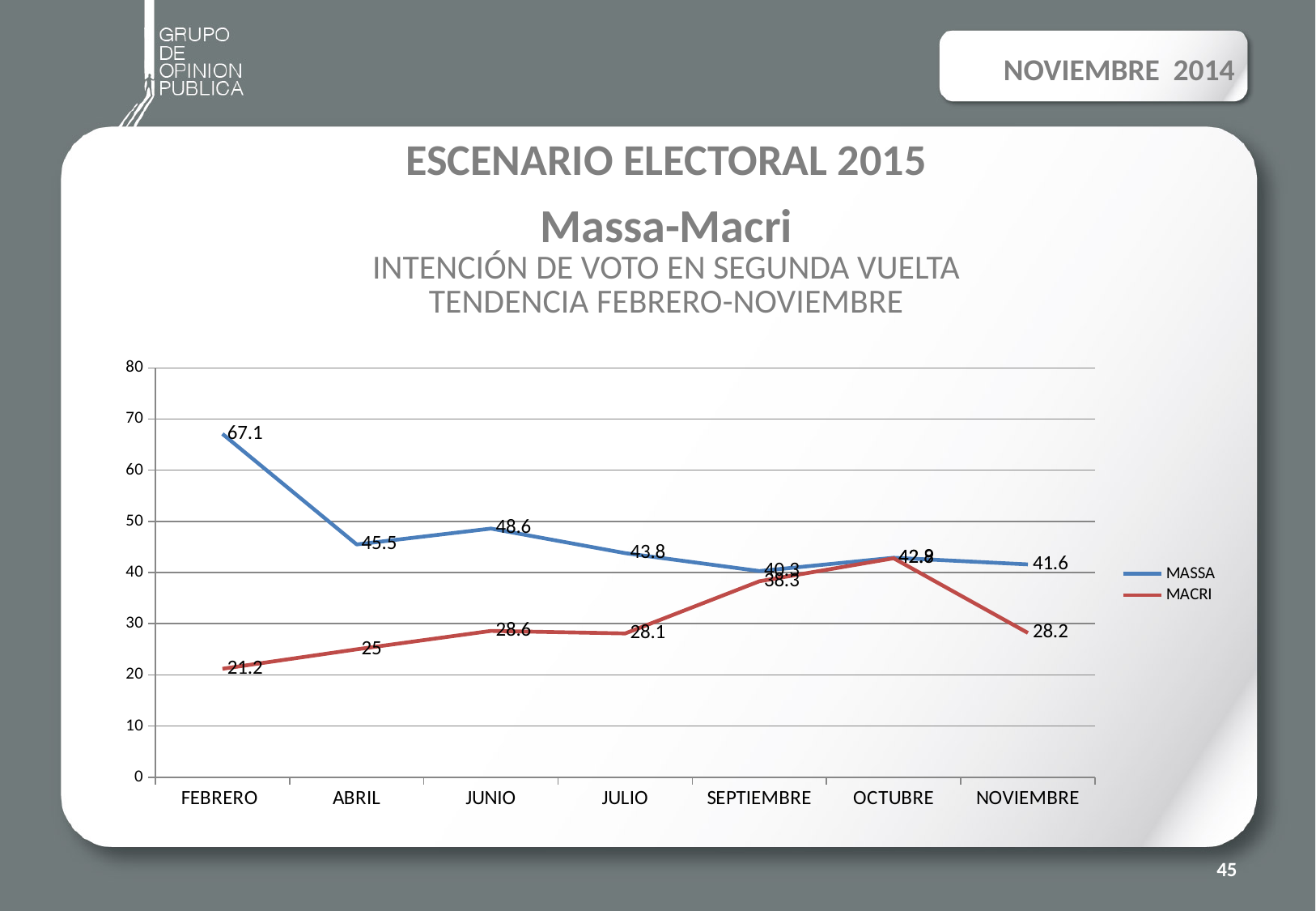
What is the value for MASSA in FEBRERO? 67.1 In which month is the MASSA value highest? FEBRERO What is the value for MACRI in FEBRERO? 21.2 What is the value for MACRI in NOVIEMBRE? 28.2 Which is larger in JULIO, the MASSA value or the MACRI value? MASSA What is the difference between MASSA and MACRI in NOVIEMBRE? 13.4 How many months are shown on the x axis? 7 Does the MASSA line generally rise or fall from FEBRERO to NOVIEMBRE? fall In which month is the MACRI value lowest? FEBRERO How many series does the legend list? 2 What is the value for MASSA in JUNIO? 48.6 What type of chart is shown on the slide? line chart